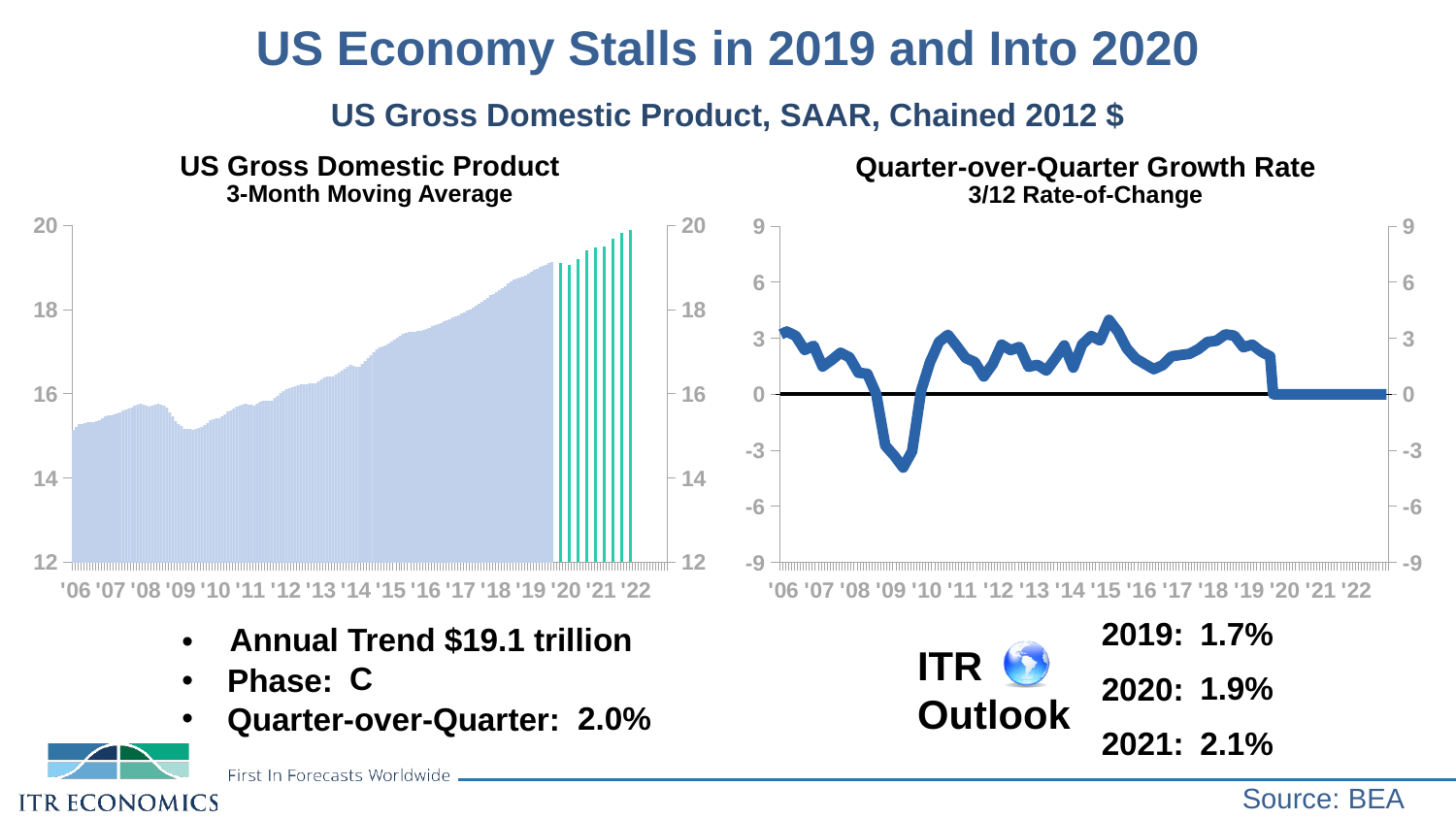
In the right chart 'Quarter-over-Quarter Growth Rate 3/12 Rate-of-Change', around which year does the line reach its lowest point? '09 What kind of chart is the left chart titled 'US Gross Domestic Product 3-Month Moving Average'? bar chart What is the highest value shown on the y axis of the right chart 'Quarter-over-Quarter Growth Rate 3/12 Rate-of-Change'? 9 What kind of chart is the right chart titled 'Quarter-over-Quarter Growth Rate 3/12 Rate-of-Change'? line chart How many year labels are shown on the x axis of the left chart 'US Gross Domestic Product 3-Month Moving Average'? 17 In the left chart 'US Gross Domestic Product 3-Month Moving Average', do the values generally rise or fall from '06 to '22? rise In the left chart 'US Gross Domestic Product 3-Month Moving Average', is the value for '06 greater or less than 16? less In the left chart 'US Gross Domestic Product 3-Month Moving Average', is the value for '19 greater or less than 18? greater In the right chart 'Quarter-over-Quarter Growth Rate 3/12 Rate-of-Change', what value does the line sit at for '21? 0 In the right chart 'Quarter-over-Quarter Growth Rate 3/12 Rate-of-Change', is the lowest value of the line greater or less than -3? less